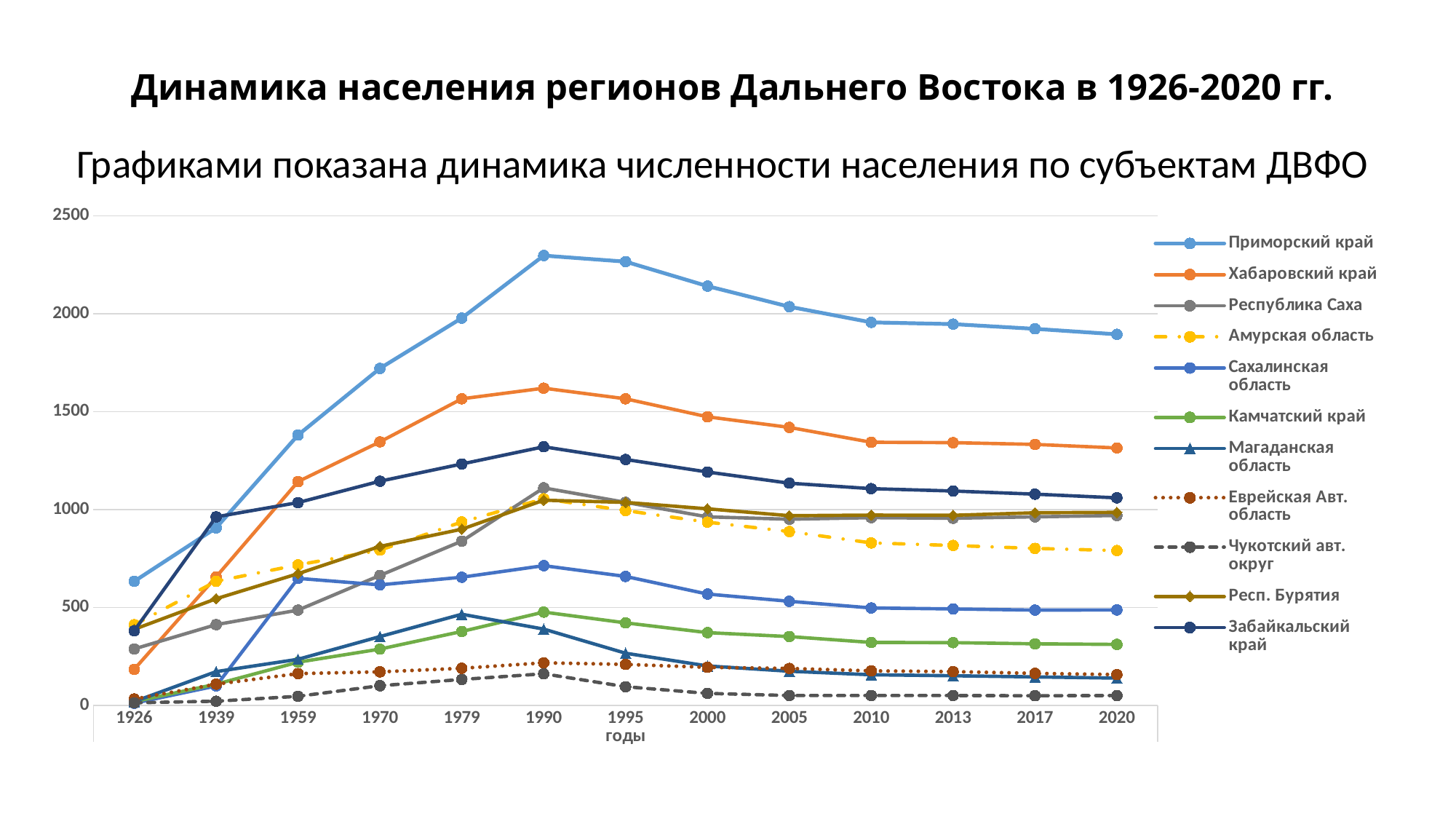
Is the value for Амурская область in 2020 greater or less than 1000? less Is the value for Приморский край in 1990 greater or less than 2000? greater How many years are marked on the x axis? 13 Which is larger in 2020, the value for Хабаровский край or the value for Республика Саха? Хабаровский край Which region has the highest value in 1990? Приморский край Does the value for Приморский край rise or fall from 1990 to 2020? fall Which region has the lowest value in 2020? Чукотский авт. округ Is the value for Магаданская область in 1990 greater or less than 500? less What is the label of the x axis? годы What kind of chart is shown on the slide? line chart How many series does the legend list? 11